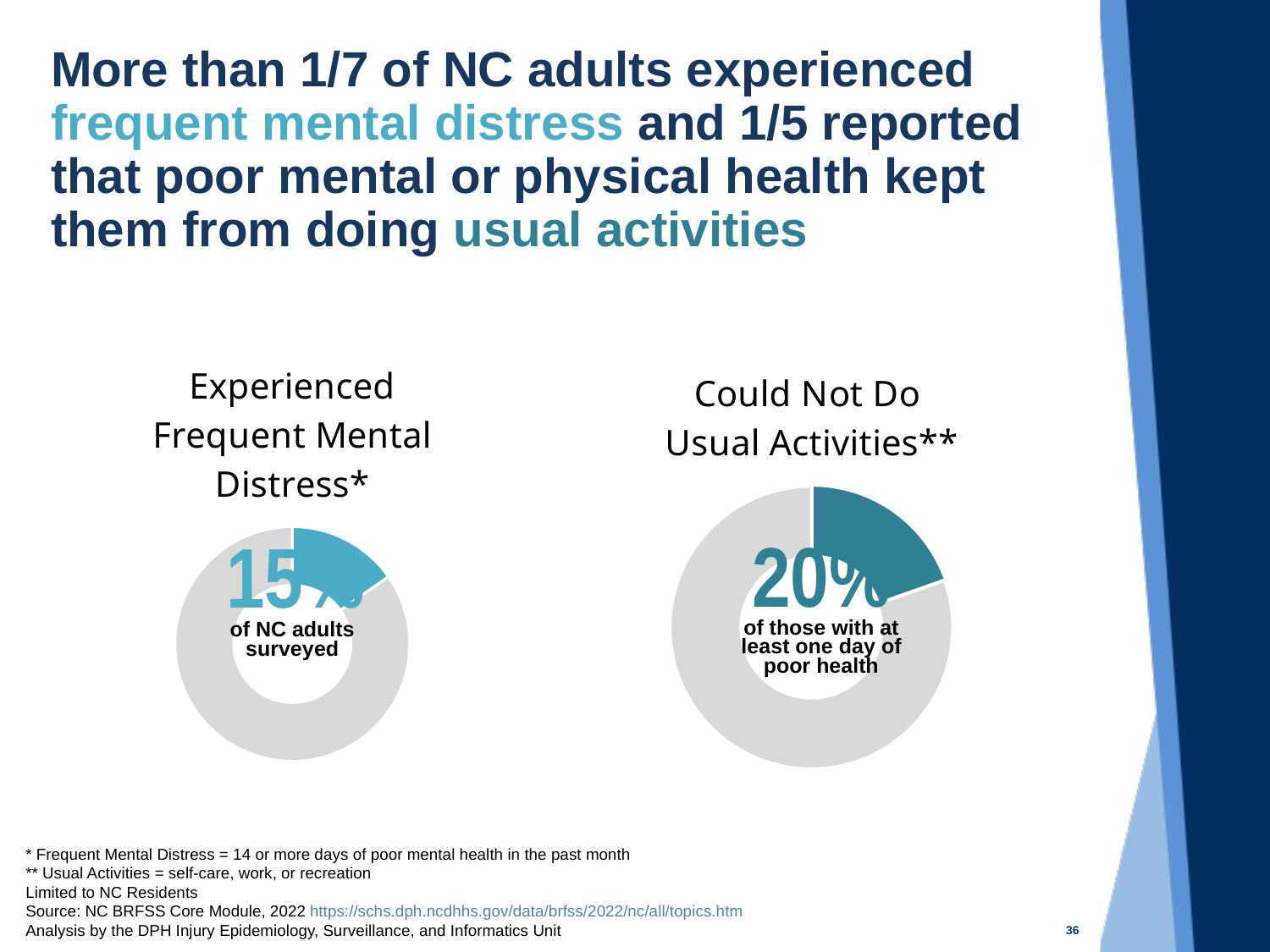
Is the value in the 'Experienced Frequent Mental Distress' chart greater or less than 20%? less What is the title of the chart on the right side of the slide? Could Not Do Usual Activities** Which chart shows the larger highlighted percentage, 'Experienced Frequent Mental Distress' or 'Could Not Do Usual Activities'? Could Not Do Usual Activities In the 'Experienced Frequent Mental Distress' chart, what share of the ring is highlighted in teal? 15% What kind of chart is used for 'Experienced Frequent Mental Distress'? Donut (pie) chart What kind of chart is used for 'Could Not Do Usual Activities'? Donut (pie) chart In the 'Experienced Frequent Mental Distress' chart, what percentage of NC adults surveyed is shown? 15% What is the difference in percentage points between the value in the 'Could Not Do Usual Activities' chart and the value in the 'Experienced Frequent Mental Distress' chart? 5 percentage points In the 'Could Not Do Usual Activities' chart, what share of the ring is highlighted in teal? 20% In the 'Could Not Do Usual Activities' chart, what percentage of those with at least one day of poor health is shown? 20% How many charts are shown on the slide? 2 What is the title of the chart on the left side of the slide? Experienced Frequent Mental Distress*